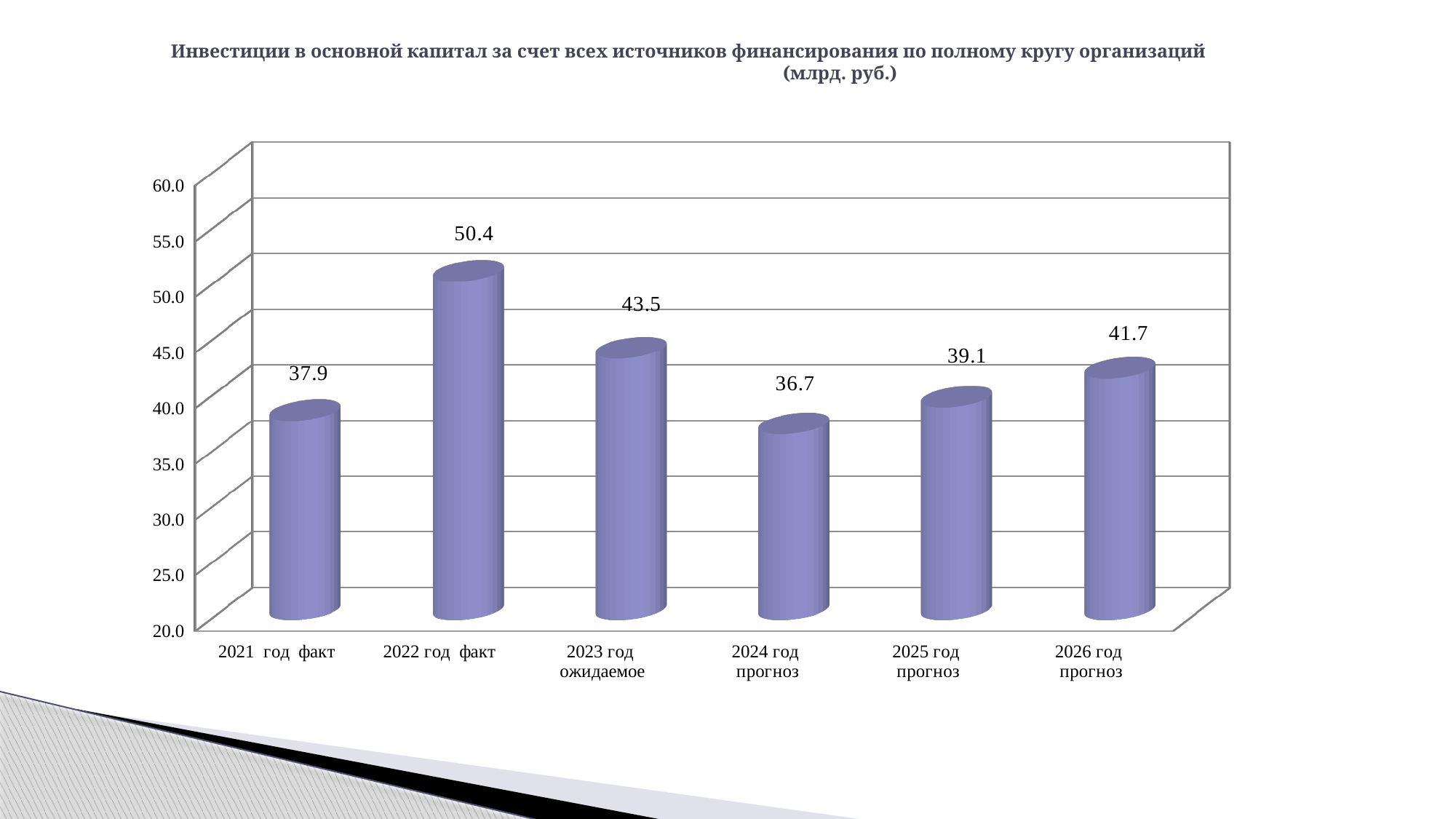
What is the value for 2026 год прогноз? 41.7 What kind of chart is shown on the slide? bar chart What is the difference between the values for 2022 год факт and 2023 год ожидаемое? 6.9 How many categories are shown on the x axis? 6 What is the value for 2022 год факт? 50.4 What is the value for 2024 год прогноз? 36.7 Which is larger, the value for 2021 год факт or the value for 2025 год прогноз? 2025 год прогноз What unit is given in parentheses in the chart title? млрд. руб. What is the difference between the values for 2026 год прогноз and 2025 год прогноз? 2.6 Which category has the lowest value? 2024 год прогноз Which category has the highest value? 2022 год факт Is the value for 2023 год ожидаемое greater or less than 40.0? greater